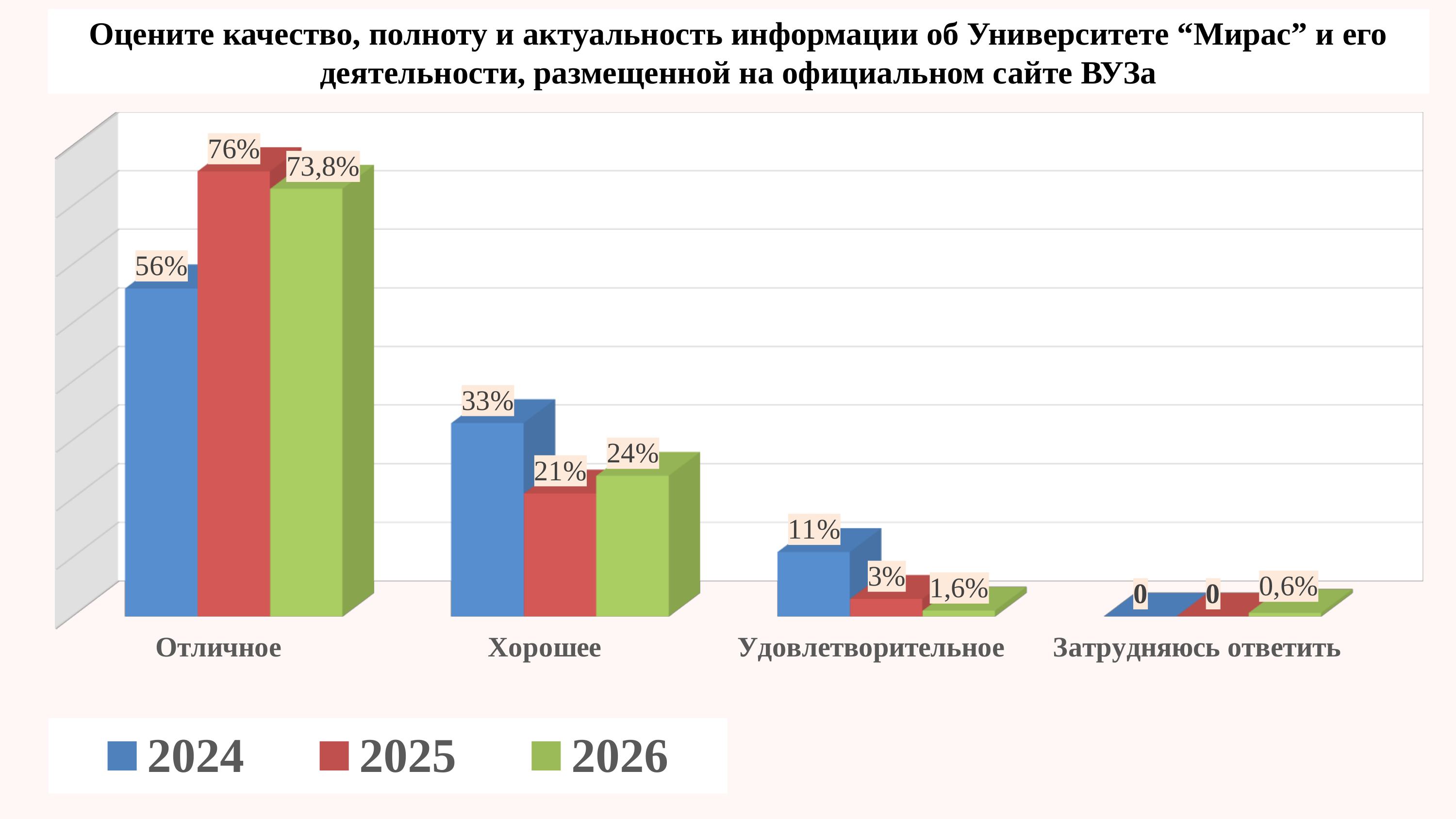
How many categories are shown on the x axis? 4 Which category has the highest value for the 2024 series? Отличное What is the value for 2026 in the "Затрудняюсь ответить" category? 0,6% How many series does the legend list? 3 What is the value for 2025 in the "Отличное" category? 76% Which colour represents the 2025 series in the legend? Red Which is larger in the "Хорошее" category: the 2024 value or the 2025 value? 2024 What kind of chart is shown on the slide? Bar chart What is the value for 2024 in the "Удовлетворительное" category? 11% What is the difference between the 2025 and 2024 values in the "Отличное" category? 20% What is the value for 2026 in the "Хорошее" category? 24% Which category has the lowest value for the 2026 series? Затрудняюсь ответить